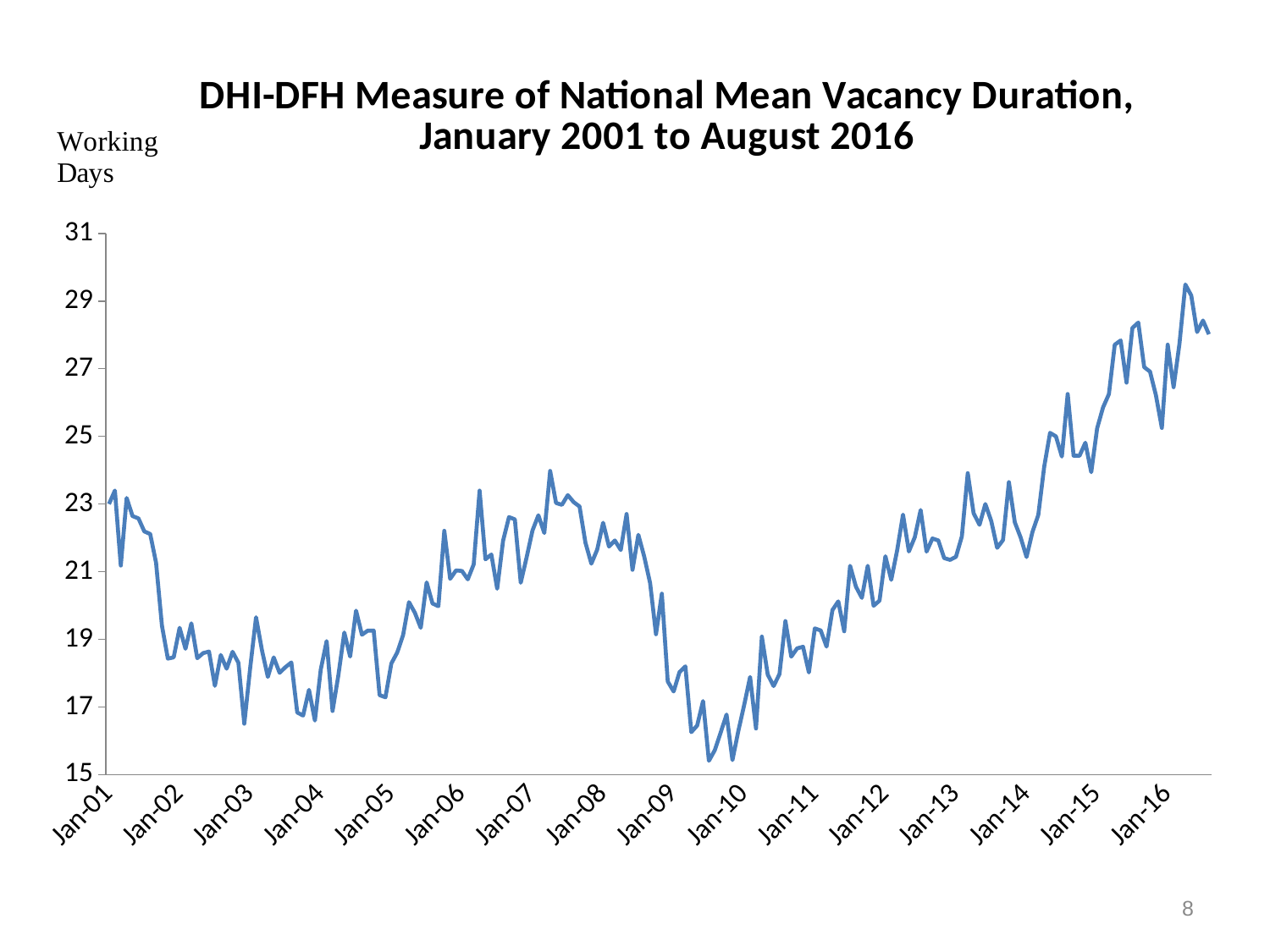
Is the value at Jan-12 greater or less than 23? less Which is higher, the value at Jan-06 or the value at Jan-04? Jan-06 Does the series rise or fall between Jan-08 and Jan-10? fall Is the value at Jan-04 greater or less than 19? less How many year labels are shown along the x axis? 16 Is the value at Jan-16 greater or less than 25? greater In which year does the series reach its highest point? 2016 What is the title of the chart? DHI-DFH Measure of National Mean Vacancy Duration, January 2001 to August 2016 What kind of chart is shown on the slide? line chart In which year does the series reach its lowest point? 2009 Does the series rise or fall between Jan-10 and Jan-16? rise What unit is the vertical axis labelled with? Working Days